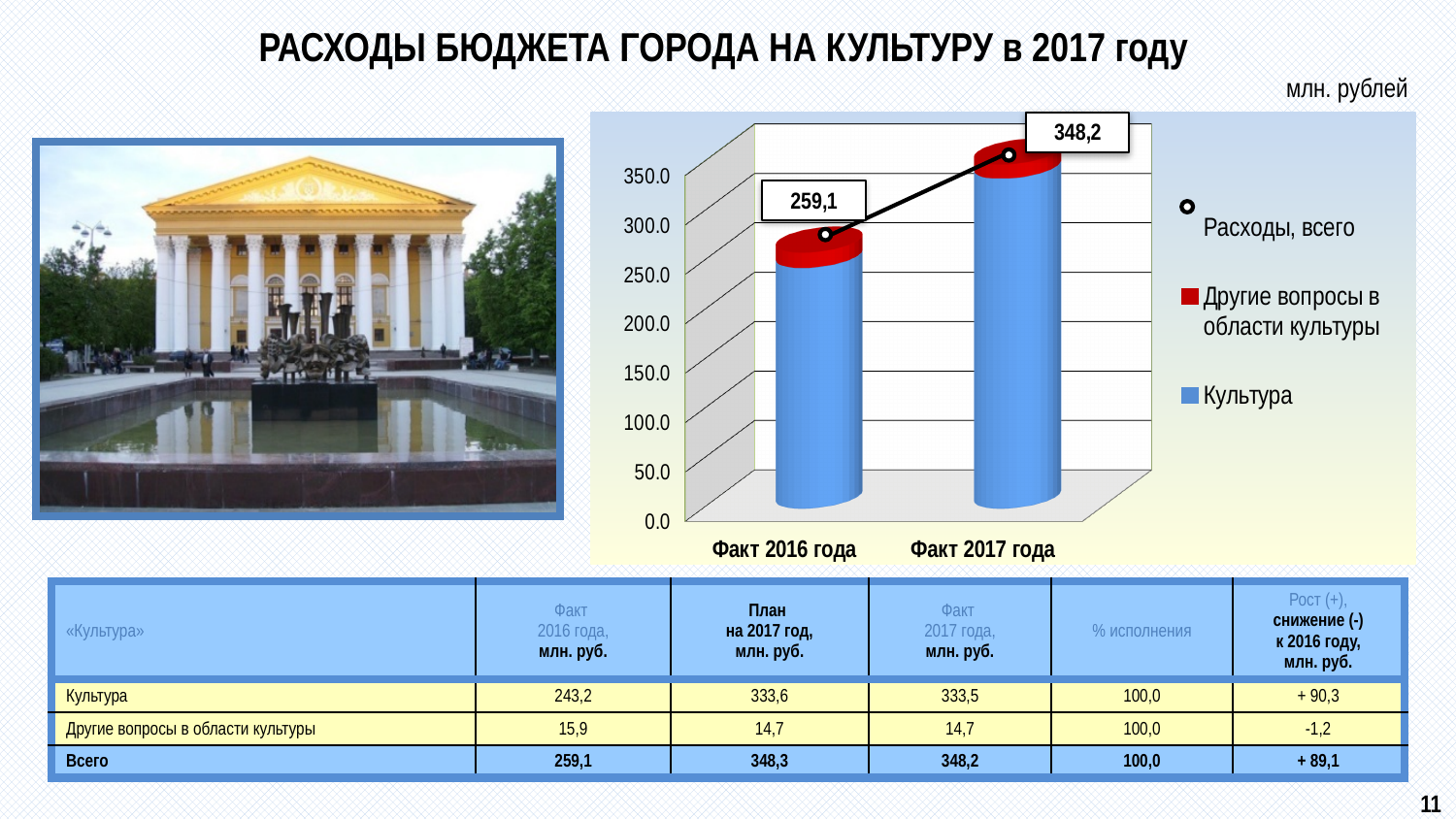
Is the value of Культура for Факт 2016 года greater or less than 200? greater Which category has the higher total expenditure, Факт 2016 года or Факт 2017 года? Факт 2017 года How many categories are shown on the x axis of the chart? 2 Which series is shown in red in the chart legend? Другие вопросы в области культуры What is the value of Расходы, всего for Факт 2016 года? 259,1 What is the difference between Расходы, всего for Факт 2017 года and Факт 2016 года? 89,1 Is the value of Культура for Факт 2017 года greater or less than 300? greater How many series does the chart legend list? 3 What kind of chart is shown on the slide? bar chart Do the total expenditures rise or fall from Факт 2016 года to Факт 2017 года? rise What is the value of Расходы, всего for Факт 2017 года? 348,2 Which category has the lowest value of Расходы, всего? Факт 2016 года